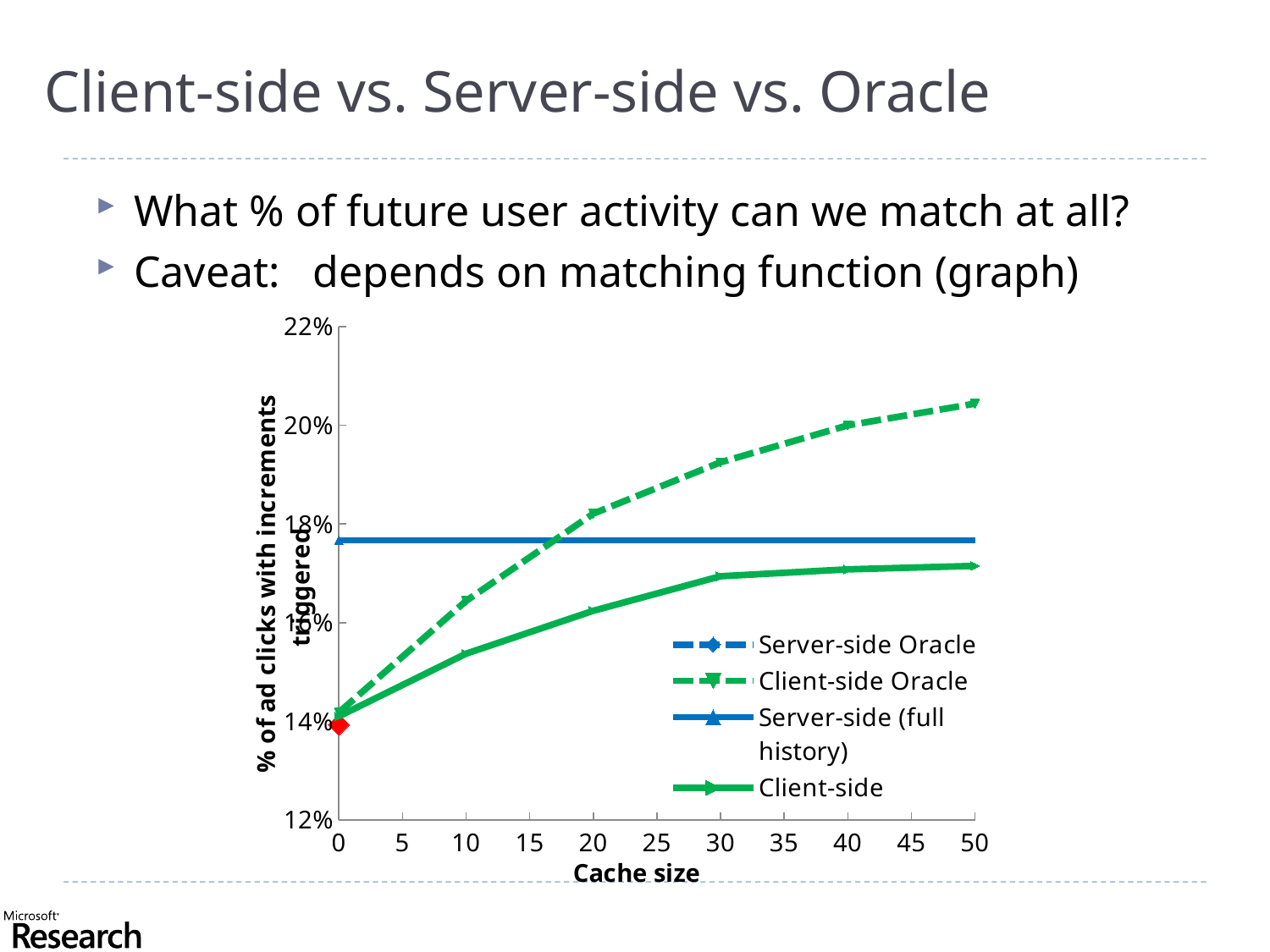
Is the value for Client-side Oracle at cache size 50 greater or less than 20%? greater Does the Client-side Oracle series rise or fall as cache size increases? rise At cache size 50, which is larger: Client-side Oracle or Client-side? Client-side Oracle Is the value for Client-side at cache size 10 greater or less than 16%? less What is the title of the x axis? Cache size Is the value for Server-side (full history) greater or less than 18%? less Which series is drawn as a green dashed line? Client-side Oracle How many series does the legend list? 4 What kind of chart is shown on the slide? line chart At cache size 10, which is larger: Server-side (full history) or Client-side Oracle? Server-side (full history)